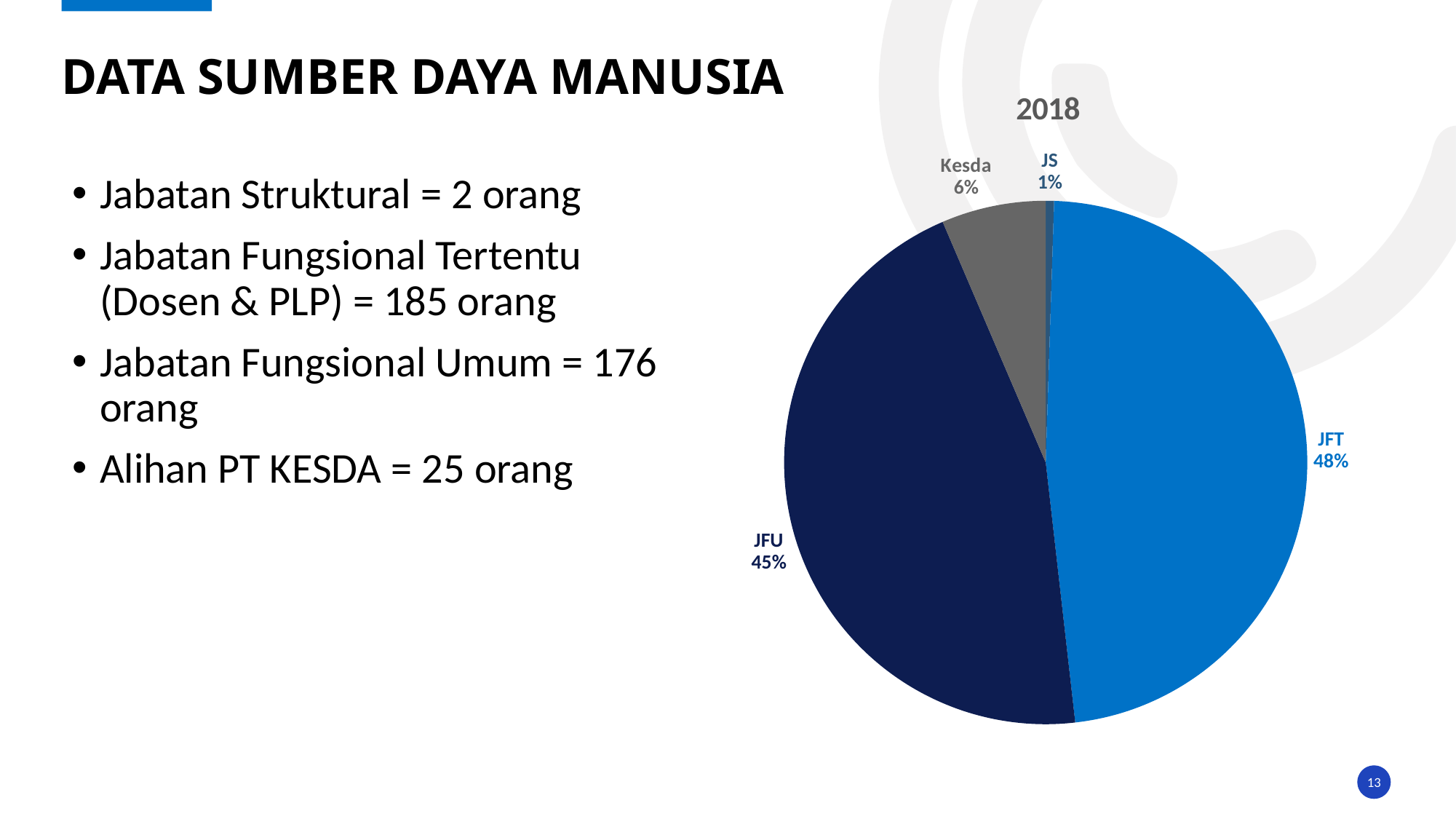
What share of the pie does Kesda represent? 6% What share of the pie does JFU represent? 45% Which slice of the pie chart is the smallest? JS What is the difference in percentage points between the JFT and JFU slices? 3% What kind of chart is shown on the slide? pie chart What is the combined share of the JFT and JFU slices? 93% Which slice of the pie chart is the largest? JFT What is the title of the pie chart? 2018 What share of the pie does JS represent? 1% Which slice is larger, Kesda or JS? Kesda How many slices does the pie chart have? 4